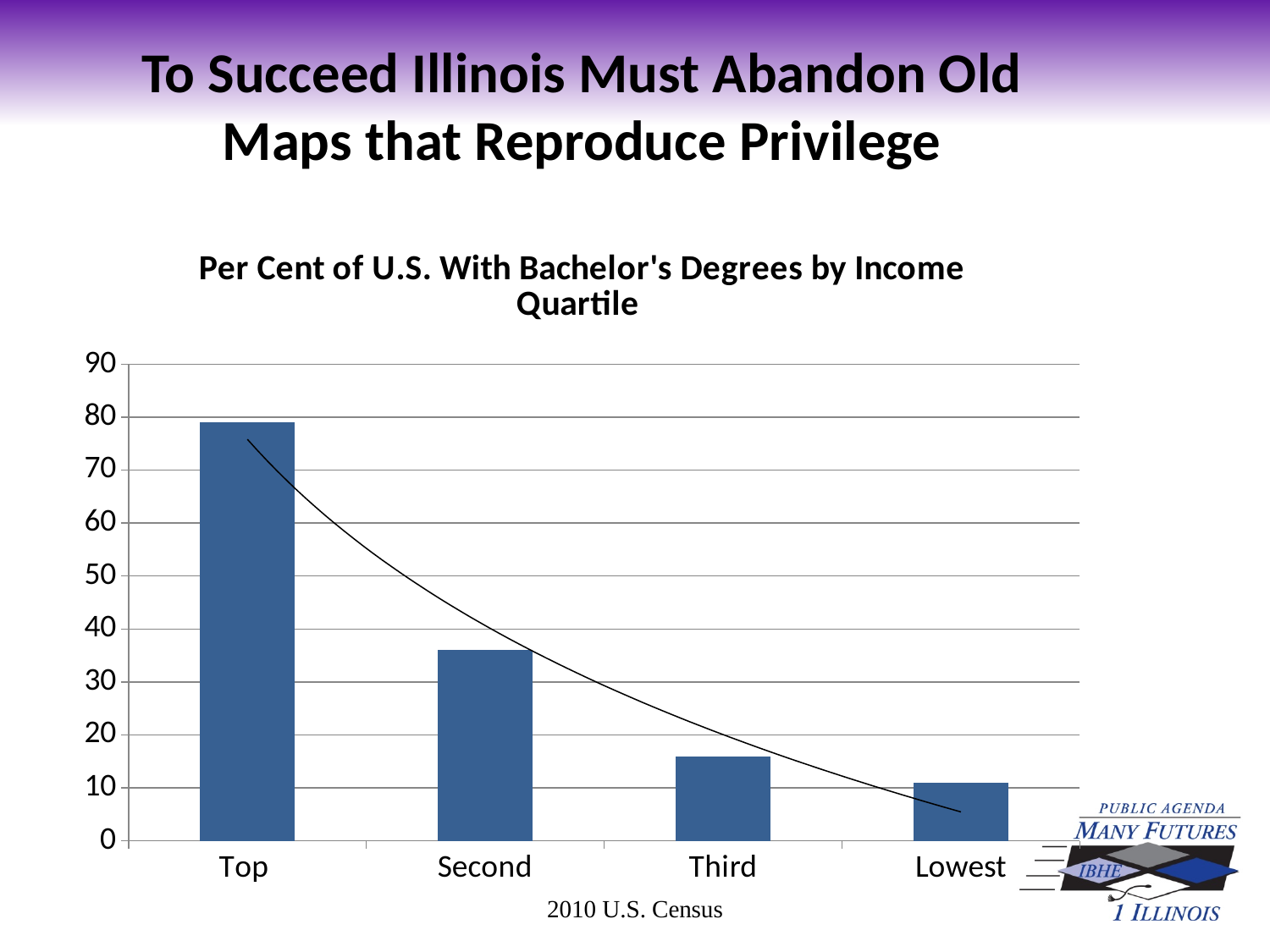
What data source is cited below the chart? 2010 U.S. Census Is the value for the Lowest quartile greater or less than 20? less Is the value for the Top quartile greater or less than 70? greater What kind of chart is shown on the slide? bar chart How many income quartile categories are shown on the x axis? 4 Do the values rise or fall moving from Top to Lowest along the x axis? fall What is the title of the chart? Per Cent of U.S. With Bachelor's Degrees by Income Quartile Is the value for the Second quartile greater or less than 40? less Which income quartile has the highest per cent with bachelor's degrees? Top Which income quartile has the lowest per cent with bachelor's degrees? Lowest Which has a larger value, the Second quartile or the Third quartile? Second